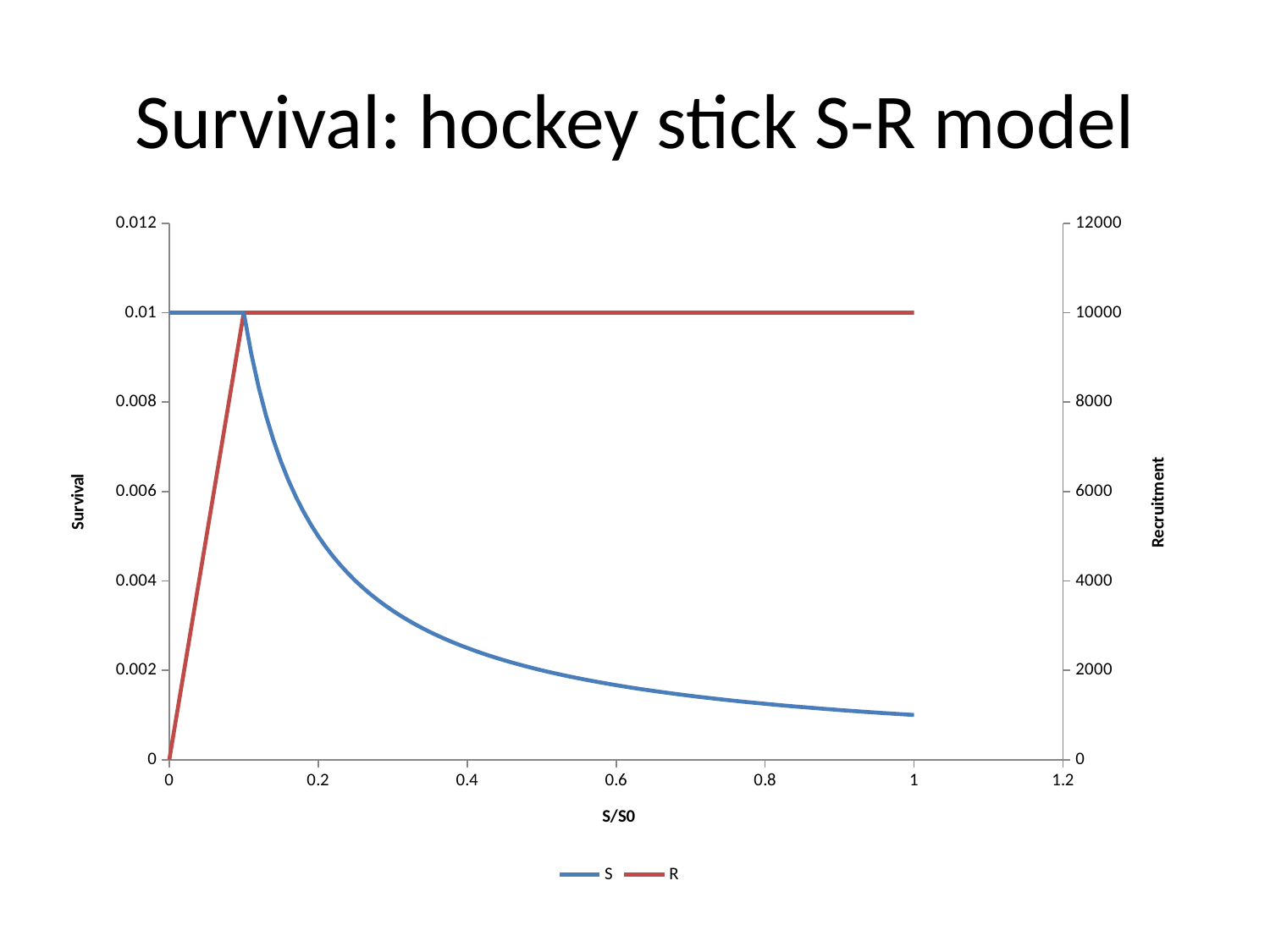
What is the value of R at S/S0 = 0? 0 Is the value of S at S/S0 = 0.4 greater or less than 0.004? less What is the title of the x axis? S/S0 What kind of chart is shown on the slide? line chart What is the value of S at S/S0 = 0? 0.01 Is the value of S at S/S0 = 0.8 greater or less than 0.002? less How many series does the legend list? 2 Is the value of R at S/S0 = 0.5 greater or less than 8000? greater Does the R series rise or fall as S/S0 increases from 0 to 0.1? rise What are the two series named in the legend? S and R Does the S series rise or fall as S/S0 increases from 0.2 to 1? fall What is the value of R at S/S0 = 1? 10000